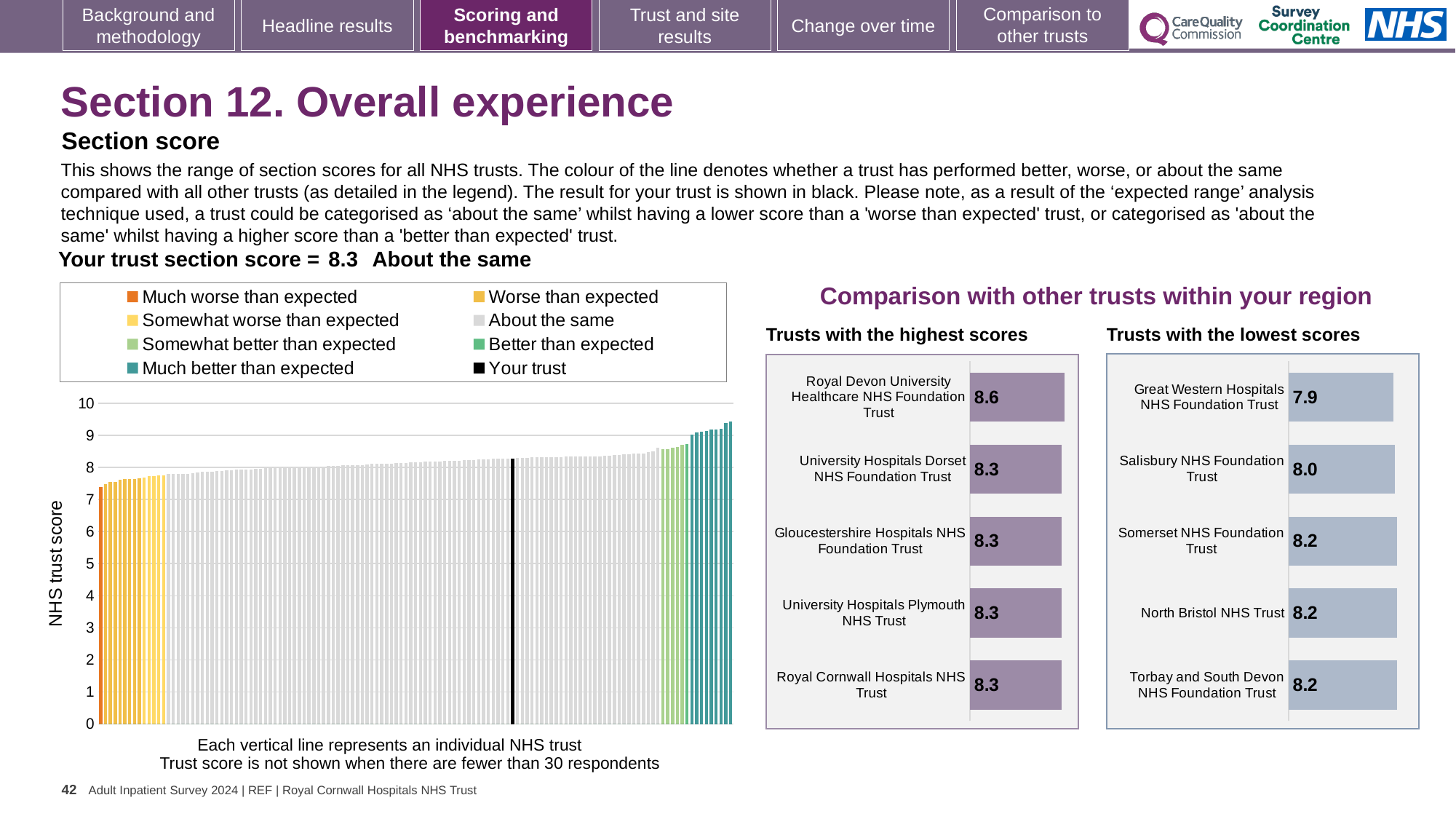
In the NHS trust score chart on the left, do the values rise or fall from left to right? Rise In the 'Trusts with the lowest scores' chart, which has the larger score: Somerset NHS Foundation Trust or Great Western Hospitals NHS Foundation Trust? Somerset NHS Foundation Trust How many trusts are shown in the 'Trusts with the highest scores' chart? 5 In the 'Trusts with the lowest scores' chart, which trust has the lowest score? Great Western Hospitals NHS Foundation Trust In the 'Trusts with the highest scores' chart, what is the score for Royal Devon University Healthcare NHS Foundation Trust? 8.6 How many entries does the legend of the NHS trust score chart on the left list? 8 In the 'Trusts with the lowest scores' chart, what is the difference between the scores of Salisbury NHS Foundation Trust and Great Western Hospitals NHS Foundation Trust? 0.1 In the 'Trusts with the highest scores' chart, which trust has the highest score? Royal Devon University Healthcare NHS Foundation Trust In the NHS trust score chart on the left, is the value for the leftmost (orange) bar greater or less than 8? less In the 'Trusts with the lowest scores' chart, what is the score for Great Western Hospitals NHS Foundation Trust? 7.9 What kind of chart is the 'Trusts with the lowest scores' chart? Bar chart In the 'Trusts with the highest scores' chart, what is the difference between the scores of Royal Devon University Healthcare NHS Foundation Trust and Royal Cornwall Hospitals NHS Trust? 0.3